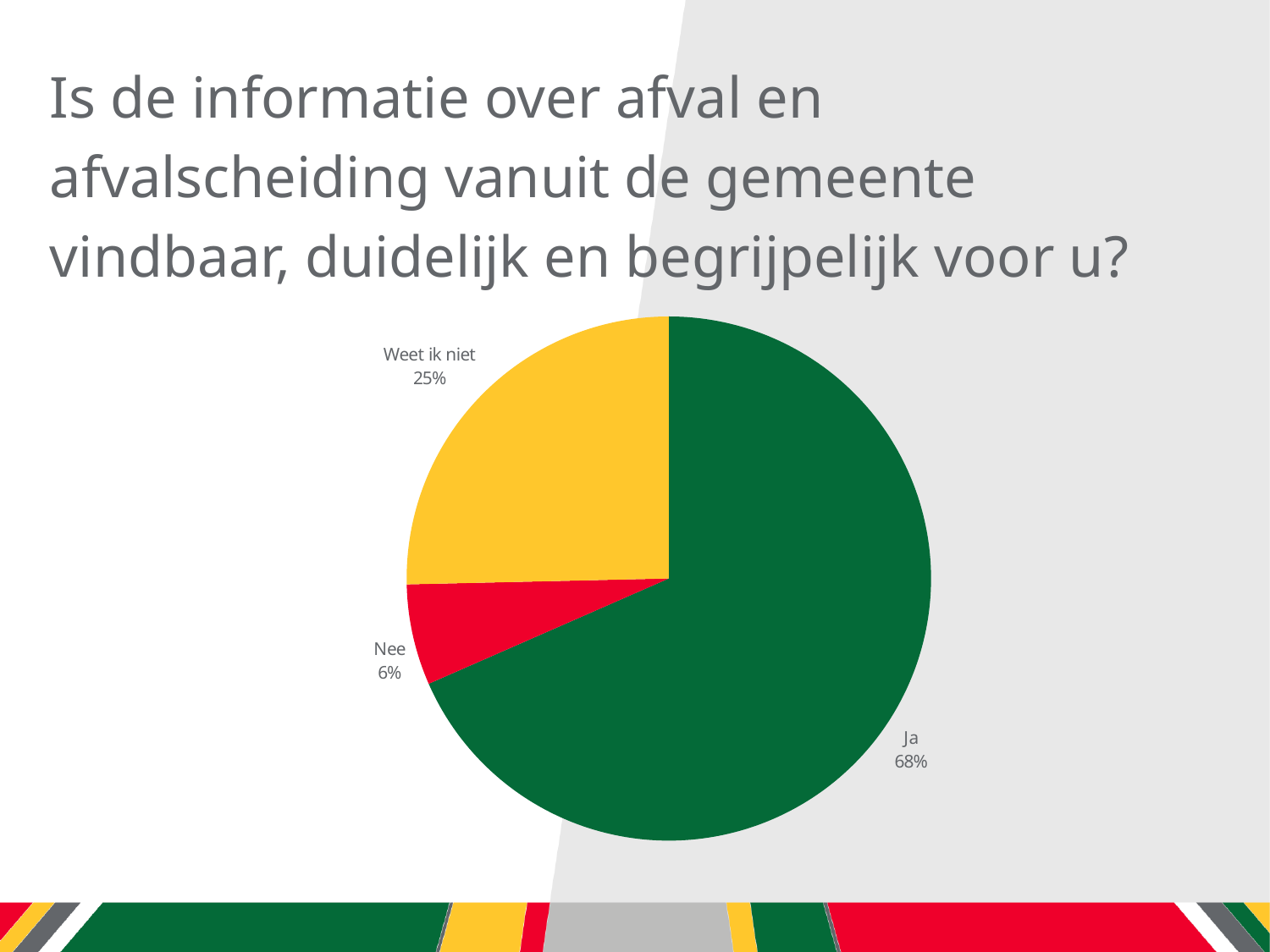
Which answer has the largest share of the pie? Ja What is the difference in percentage points between "Ja" and "Weet ik niet"? 43 What percentage of respondents answered "Ja"? 68% What is the difference in percentage points between "Weet ik niet" and "Nee"? 19 Which answer has the smallest share of the pie? Nee What percentage of respondents answered "Nee"? 6% Which is larger, the share for "Weet ik niet" or the share for "Nee"? Weet ik niet What kind of chart is shown on the slide? pie chart What percentage of respondents answered "Weet ik niet"? 25% How many slices does the pie chart have? 3 What colour is the "Ja" slice of the pie? green What colour is the "Nee" slice of the pie? red